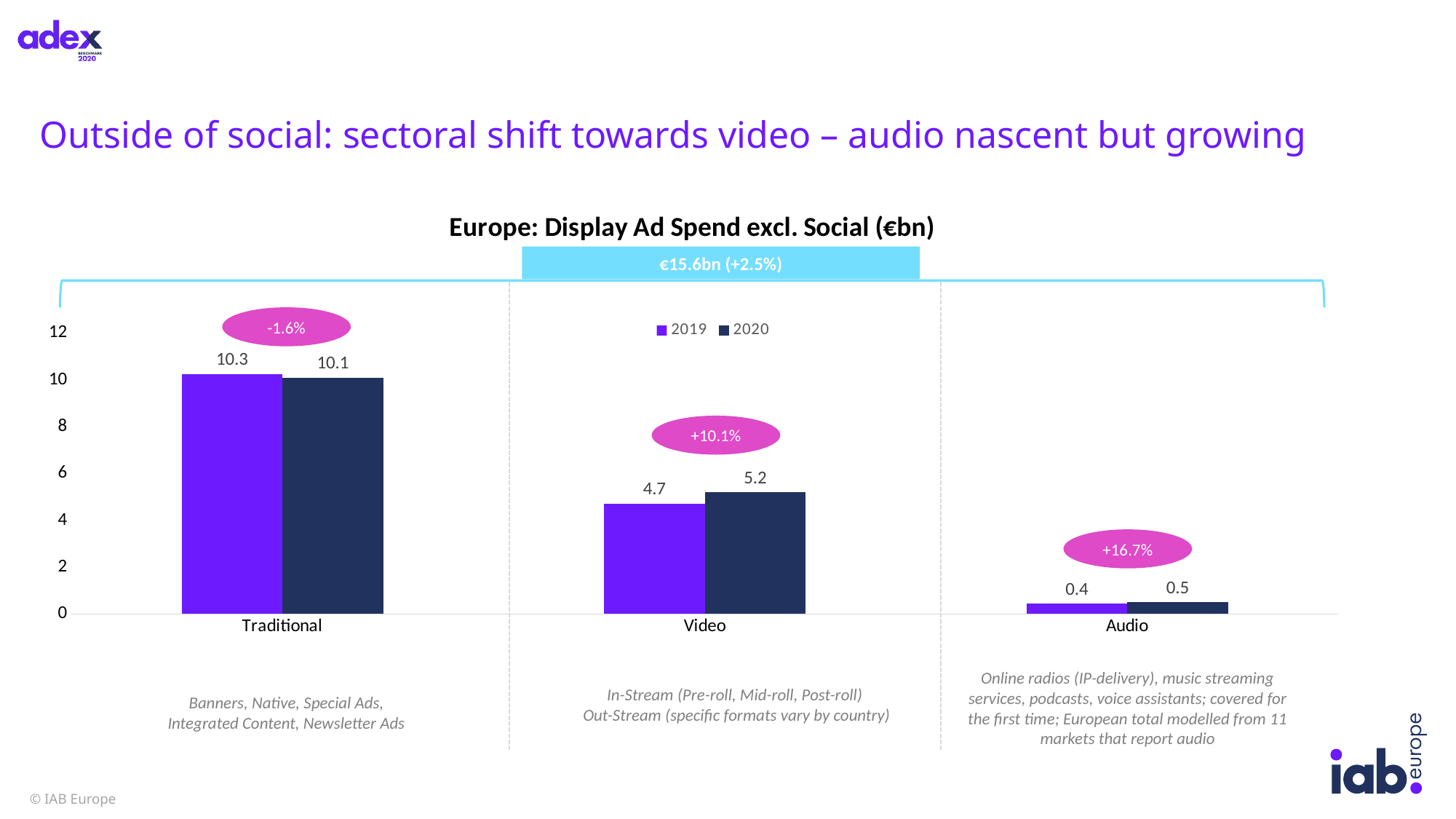
Which category has the highest 2020 value? Traditional How many categories are shown on the x axis? 3 How many series does the legend list? 2 Which is larger for Traditional: the 2019 value or the 2020 value? 2019 What kind of chart is shown? bar chart Is the 2020 value for Video greater or less than 4? greater What is the difference between the 2020 and 2019 values for Video? 0.5 Which category has the lowest 2019 value? Audio What is the 2020 value for Video? 5.2 What is the title of the chart? Europe: Display Ad Spend excl. Social (€bn) What is the 2019 value for Traditional? 10.3 What is the 2019 value for Audio? 0.4